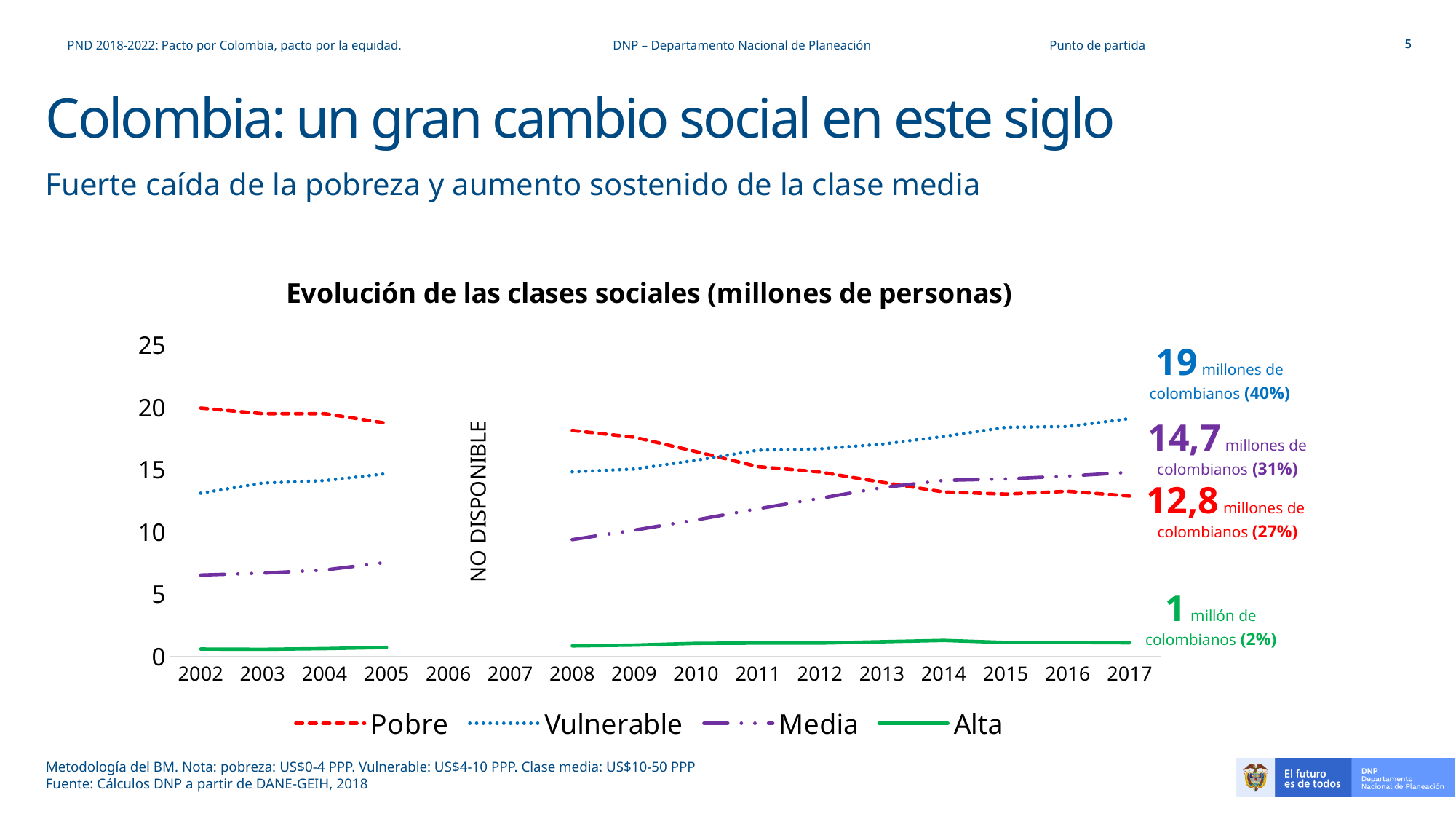
What is the value for Vulnerable in 2017, in millions of people? 19 How many series does the legend list? 4 Is the value for Media in 2002 greater or less than 10? less Does the Pobre series rise or fall from 2002 to 2017? fall Which series has the highest value in 2017? Vulnerable What kind of chart is shown on the slide? line chart In 2002, which is larger: Pobre or Vulnerable? Pobre What is the value for Media in 2017, in millions of people? 14,7 What percentage of Colombians does the Alta class represent in 2017? 2% What is the value for Pobre in 2017, in millions of people? 12,8 Which series has the lowest value in 2017? Alta What is the difference between the Vulnerable and Pobre values in 2017, in millions? 6,2